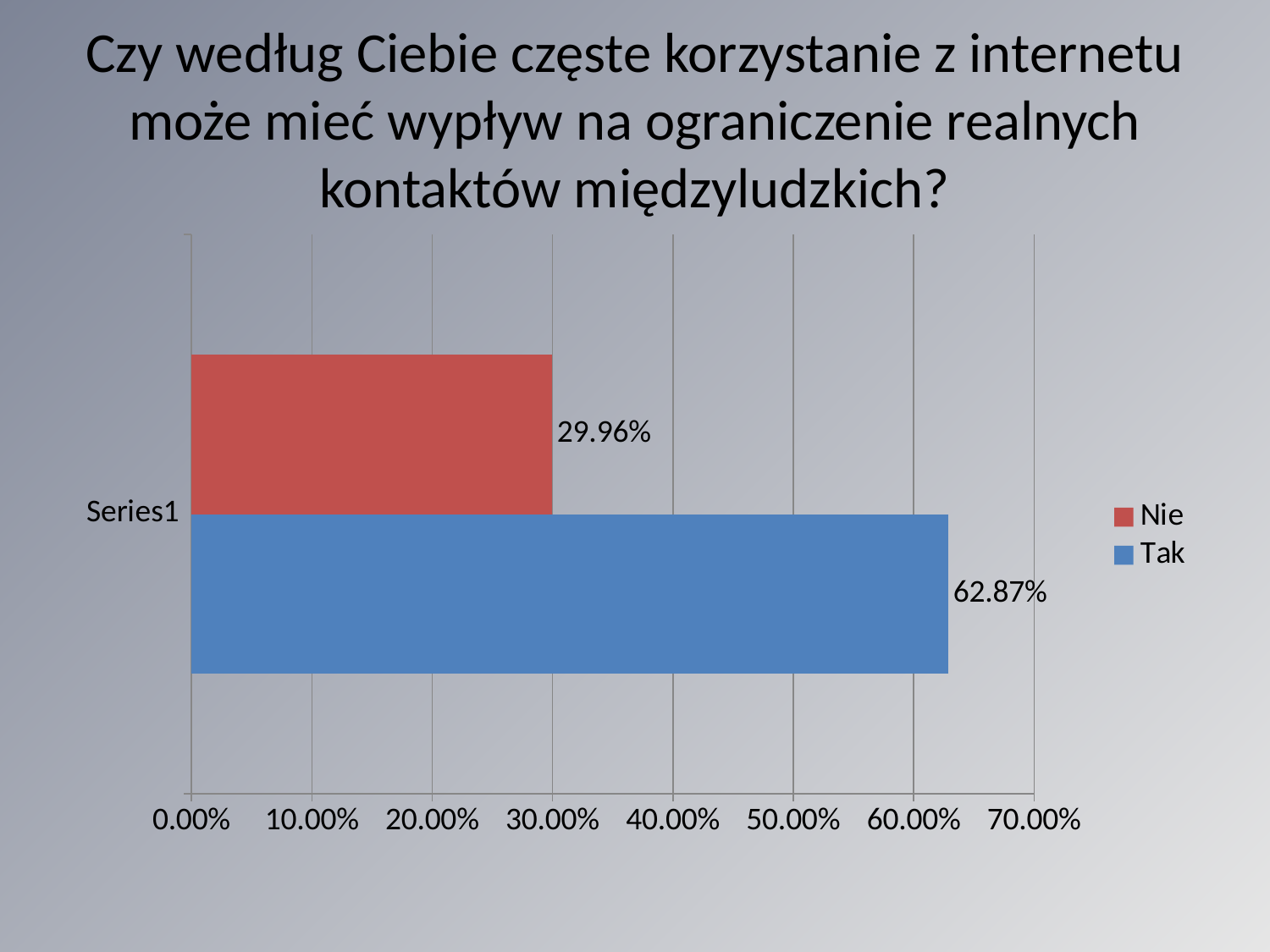
Which is larger, the value for Tak or the value for Nie? Tak What is the value for Nie? 29.96% Is the value for Tak greater or less than 60.00%? greater Which series has the lowest value? Nie How many series does the legend list? 2 What is the difference between the values for Tak and Nie? 32.91% What is the highest value shown on the x axis? 70.00% What kind of chart is shown on the slide? bar chart What is the value for Tak? 62.87% Is the value for Nie greater or less than 30.00%? less What colour is the bar for Nie? red Which series has the highest value? Tak